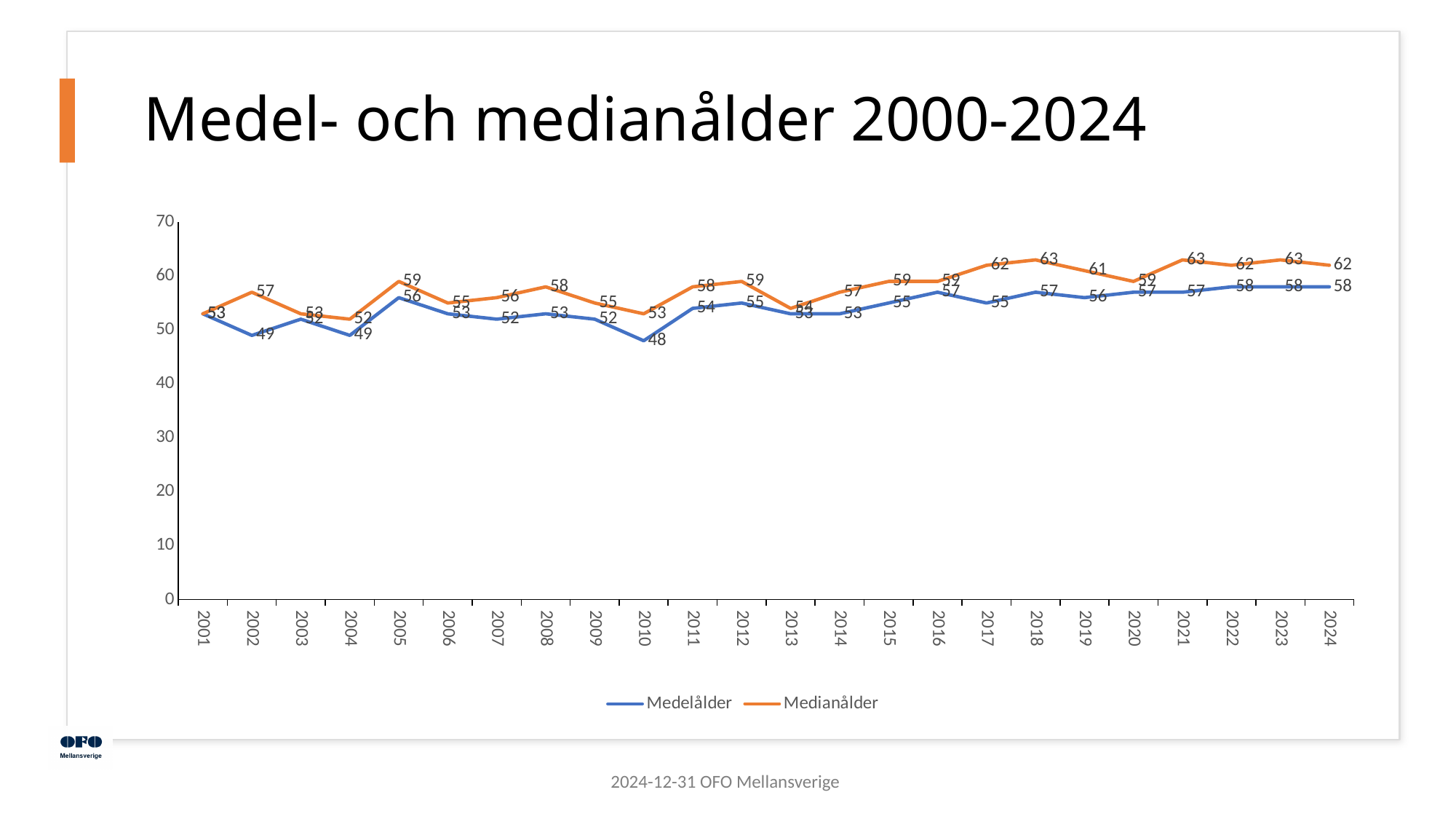
What is the Medianålder value for 2018? 63 What is the Medelålder value for 2010? 48 What is the title of the chart? Medel- och medianålder 2000-2024 In which year is the Medelålder lowest? 2010 Is the Medianålder value for 2024 greater or less than 60? greater Does the Medianålder rise or fall from 2013 to 2018? rise What kind of chart is shown on the slide? line chart What is the difference between Medianålder and Medelålder in 2017? 7 In 2002, which is larger, Medelålder or Medianålder? Medianålder In which year is the Medianålder lowest? 2004 How many series does the legend list? 2 How many years are shown on the x axis? 24